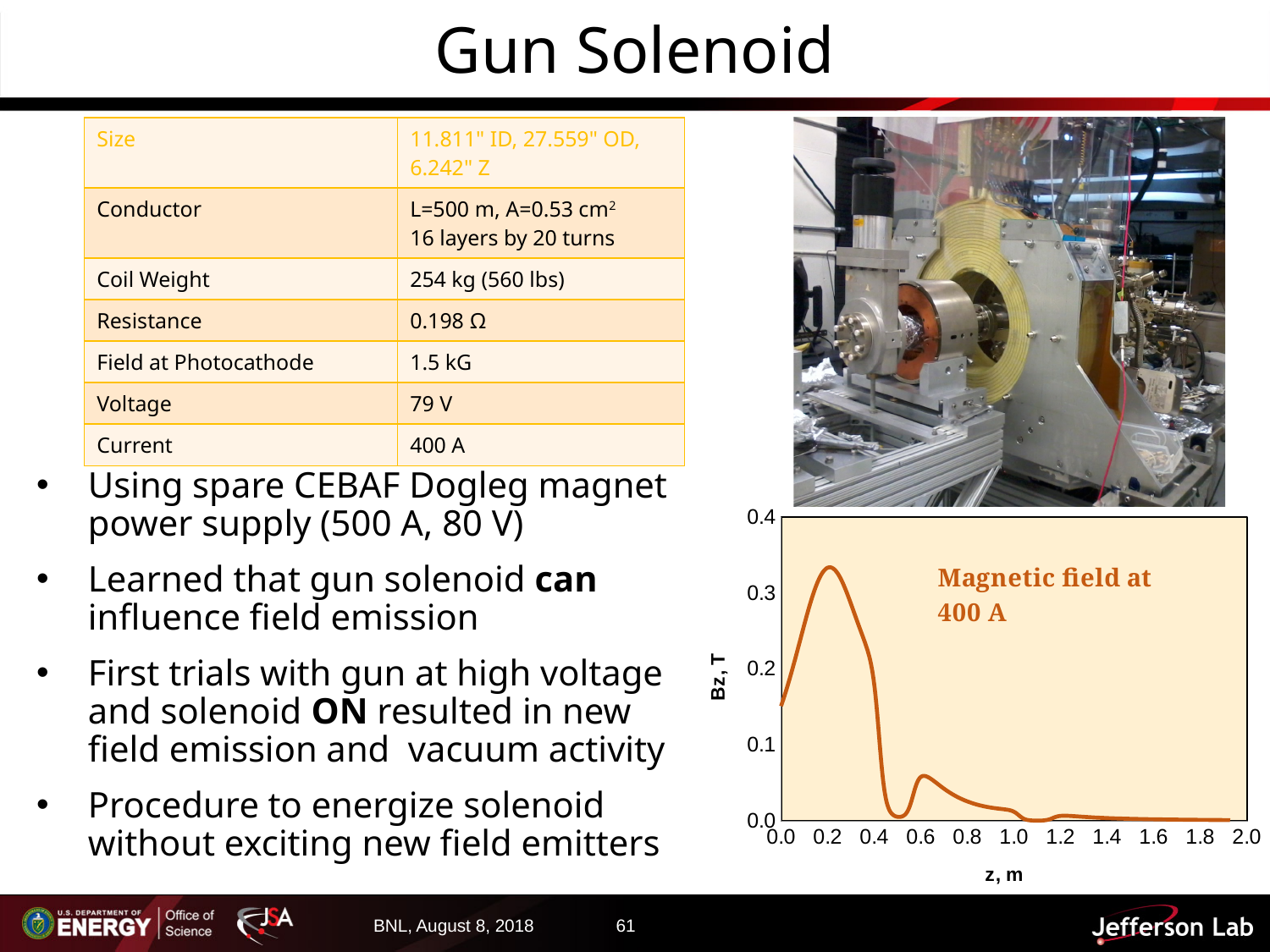
Is the value of Bz at z = 0.6 m greater or less than 0.1? less Is the peak value of Bz on the chart greater or less than 0.3? greater What is the label of the y axis of the chart? Bz, T Is the value of Bz at z = 1.0 m greater or less than 0.1? less What kind of chart is shown on the slide? line chart What is the label of the x axis of the chart? z, m Does Bz rise or fall along the x axis between z = 0.2 m and z = 0.5 m? fall Which is larger on the chart: Bz at z = 0.2 m or Bz at z = 0.6 m? Bz at z = 0.2 m What is the maximum value shown on the y axis of the chart? 0.4